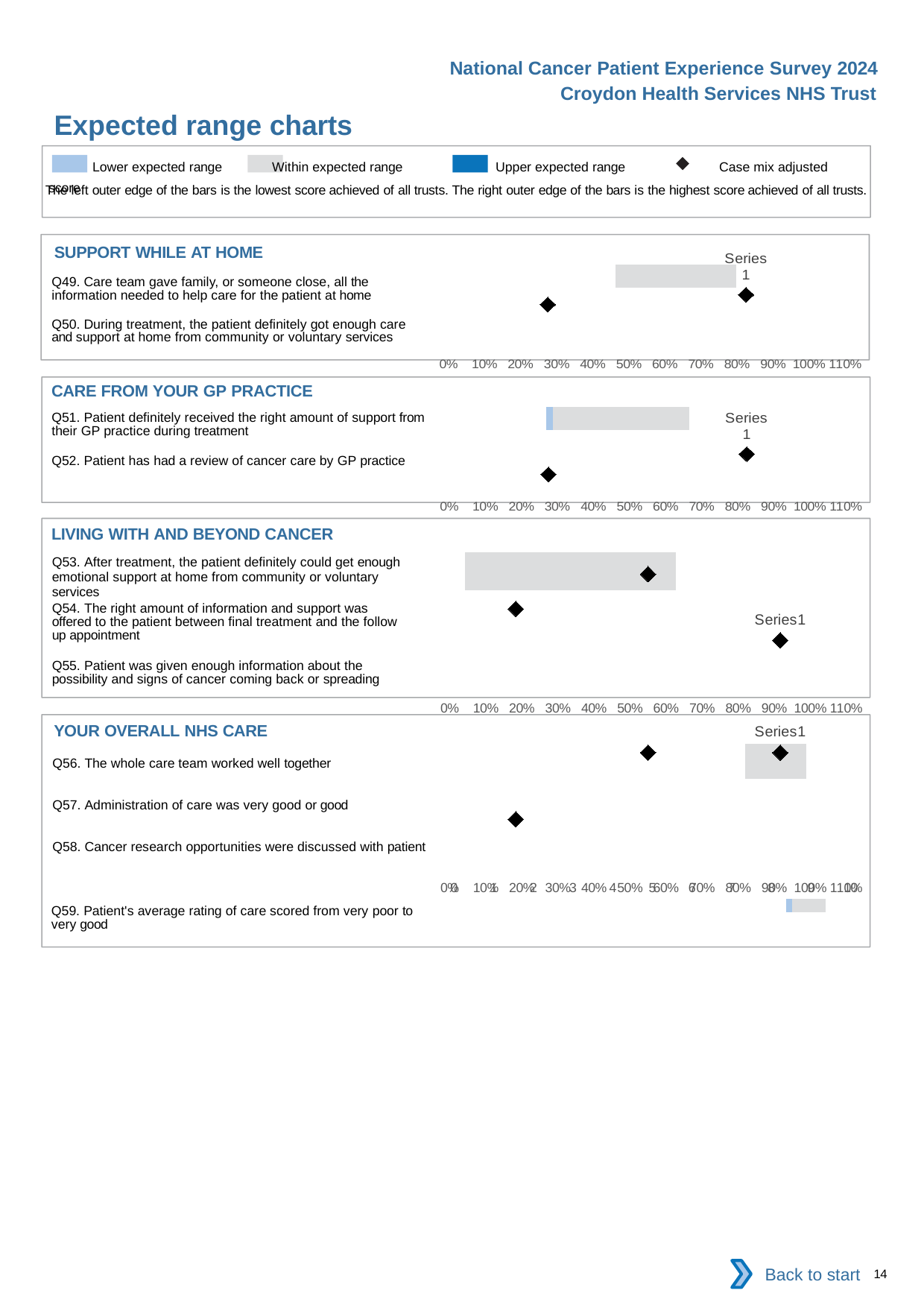
How many questions are listed in the CARE FROM YOUR GP PRACTICE section? 2 In the CARE FROM YOUR GP PRACTICE chart, is the lower diamond marker greater or less than 50%? less In the LIVING WITH AND BEYOND CANCER chart, is the leftmost diamond marker greater or less than 30%? less How many questions are listed in the YOUR OVERALL NHS CARE section? 4 How many entries does the legend at the top of the slide list? 4 How many questions are listed in the LIVING WITH AND BEYOND CANCER section? 3 In the SUPPORT WHILE AT HOME chart, is the rightmost diamond marker greater or less than 70%? greater What is the highest percentage label shown on the x axis of the charts? 110% What kind of chart is used in the SUPPORT WHILE AT HOME section? bar chart What symbol represents the case mix adjusted score in the legend? a diamond